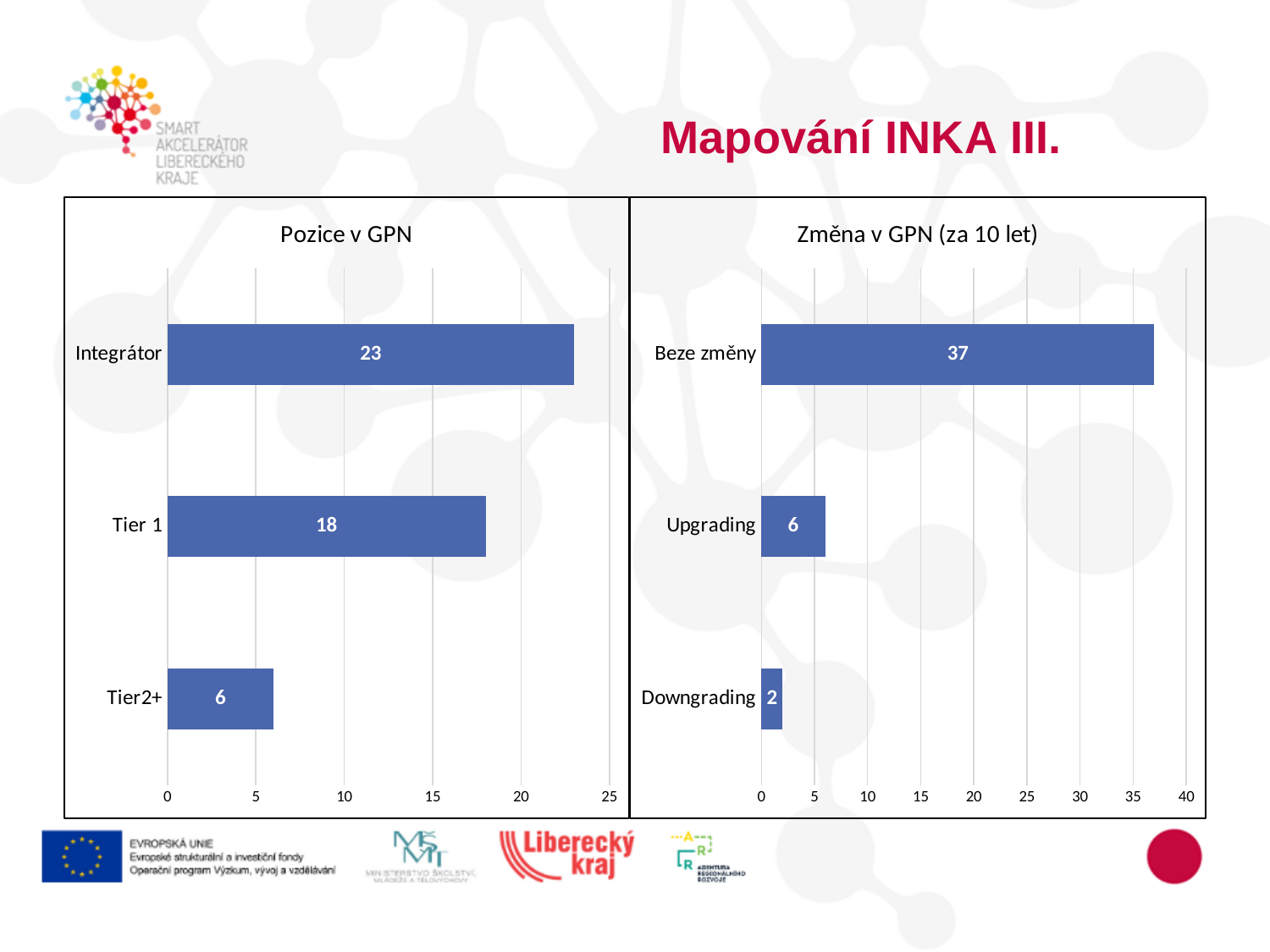
In the 'Pozice v GPN' chart, what is the difference between Integrátor and Tier 1? 5 In the 'Změna v GPN (za 10 let)' chart, what is the value for Beze změny? 37 In the 'Změna v GPN (za 10 let)' chart, which category has the highest value? Beze změny In the 'Pozice v GPN' chart, what is the value for Tier 1? 18 In the 'Pozice v GPN' chart, which category has the lowest value? Tier2+ In the 'Změna v GPN (za 10 let)' chart, which is larger, Upgrading or Downgrading? Upgrading In the 'Změna v GPN (za 10 let)' chart, what is the difference between Upgrading and Downgrading? 4 In the 'Pozice v GPN' chart, what is the value for Integrátor? 23 What is the title of the chart on the left side of the slide? Pozice v GPN What kind of chart is the 'Změna v GPN (za 10 let)' chart? Bar chart In the 'Změna v GPN (za 10 let)' chart, what is the value for Downgrading? 2 In the 'Pozice v GPN' chart, how many categories are shown? 3